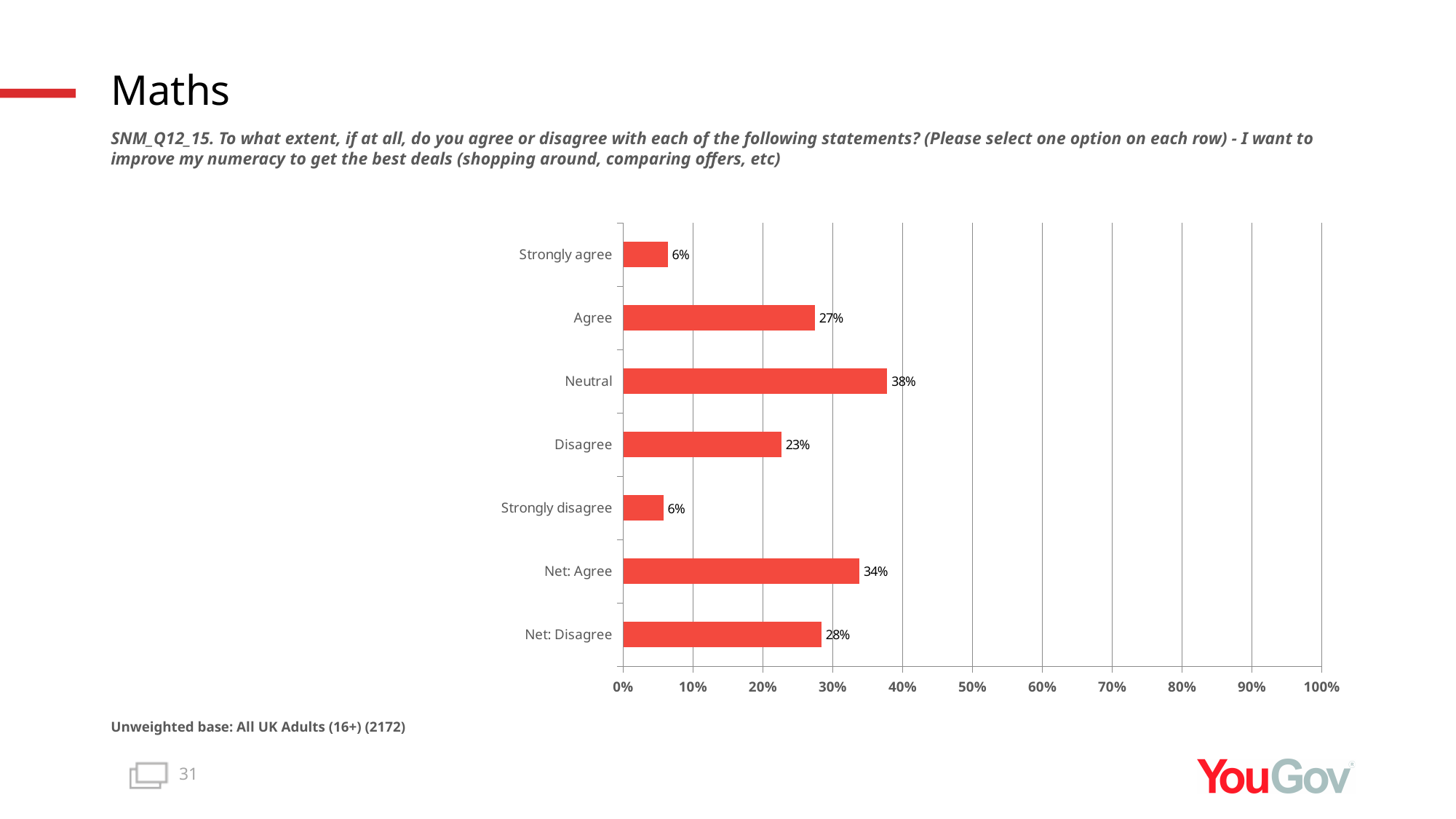
What is the value shown for 'Strongly agree'? 6% Which category has the highest value on the chart? Neutral What is the value shown for 'Net: Agree'? 34% How many categories are shown on the chart? 7 What percentage of respondents selected 'Disagree'? 23% What is the unweighted base stated below the chart? All UK Adults (16+) (2172) What kind of chart is shown on the slide? Bar chart What is the difference between 'Net: Agree' and 'Net: Disagree'? 6% What is the difference between 'Agree' and 'Strongly agree'? 21% Which is larger, 'Agree' or 'Disagree'? Agree Is the value for 'Neutral' greater or less than 30%? greater What percentage of respondents selected 'Neutral'? 38%